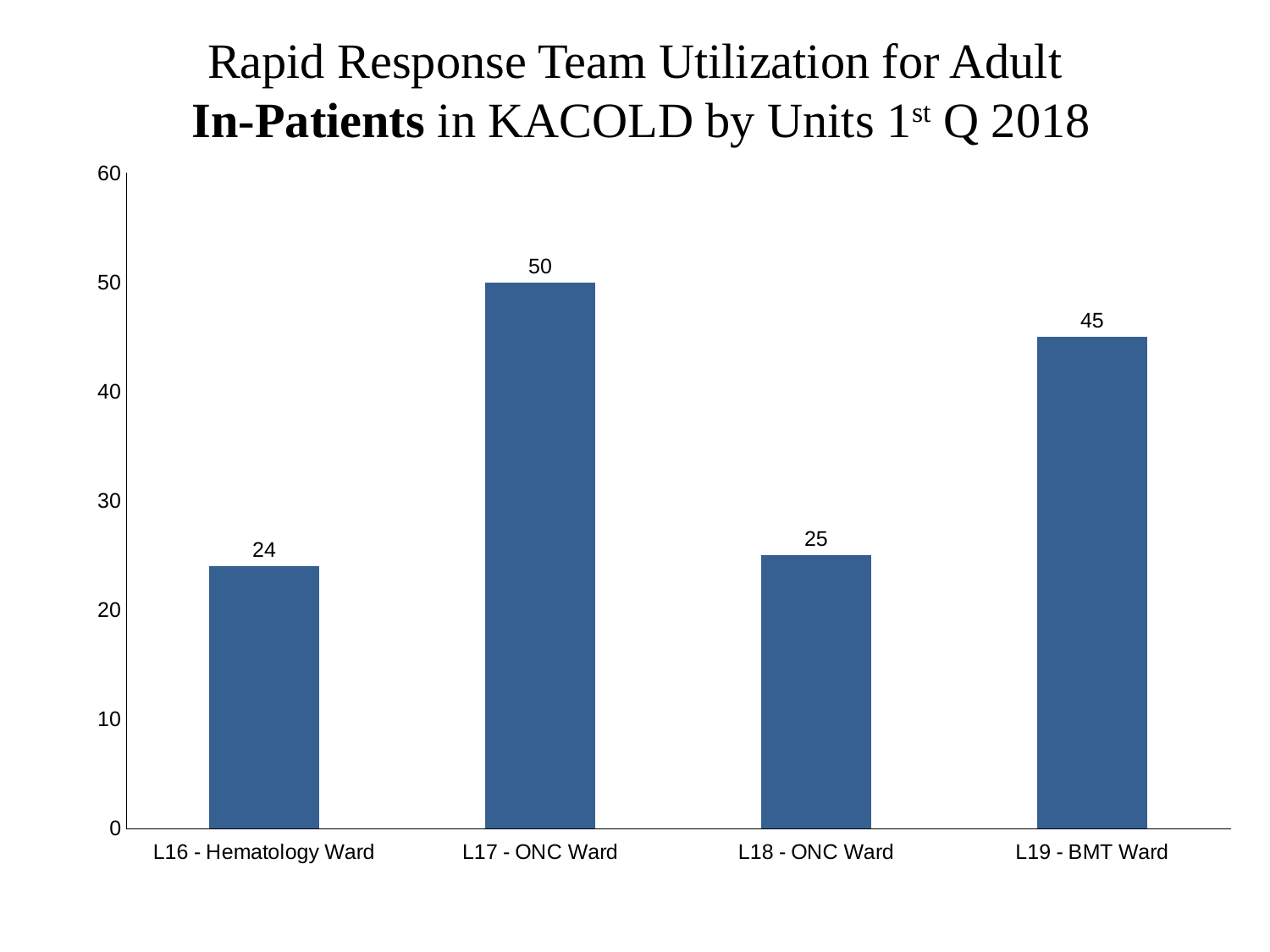
What is the value for L16 - Hematology Ward? 24 What is the value for L18 - ONC Ward? 25 Is the value for L19 - BMT Ward greater or less than 40? greater Which unit has the lowest value? L16 - Hematology Ward What is the difference between the values for L17 - ONC Ward and L19 - BMT Ward? 5 What kind of chart is shown on the slide? bar chart What is the difference between the values for L18 - ONC Ward and L16 - Hematology Ward? 1 Which is larger, the value for L19 - BMT Ward or the value for L18 - ONC Ward? L19 - BMT Ward What is the value for L17 - ONC Ward? 50 How many units are shown on the chart? 4 Which unit has the highest value? L17 - ONC Ward What is the value for L19 - BMT Ward? 45